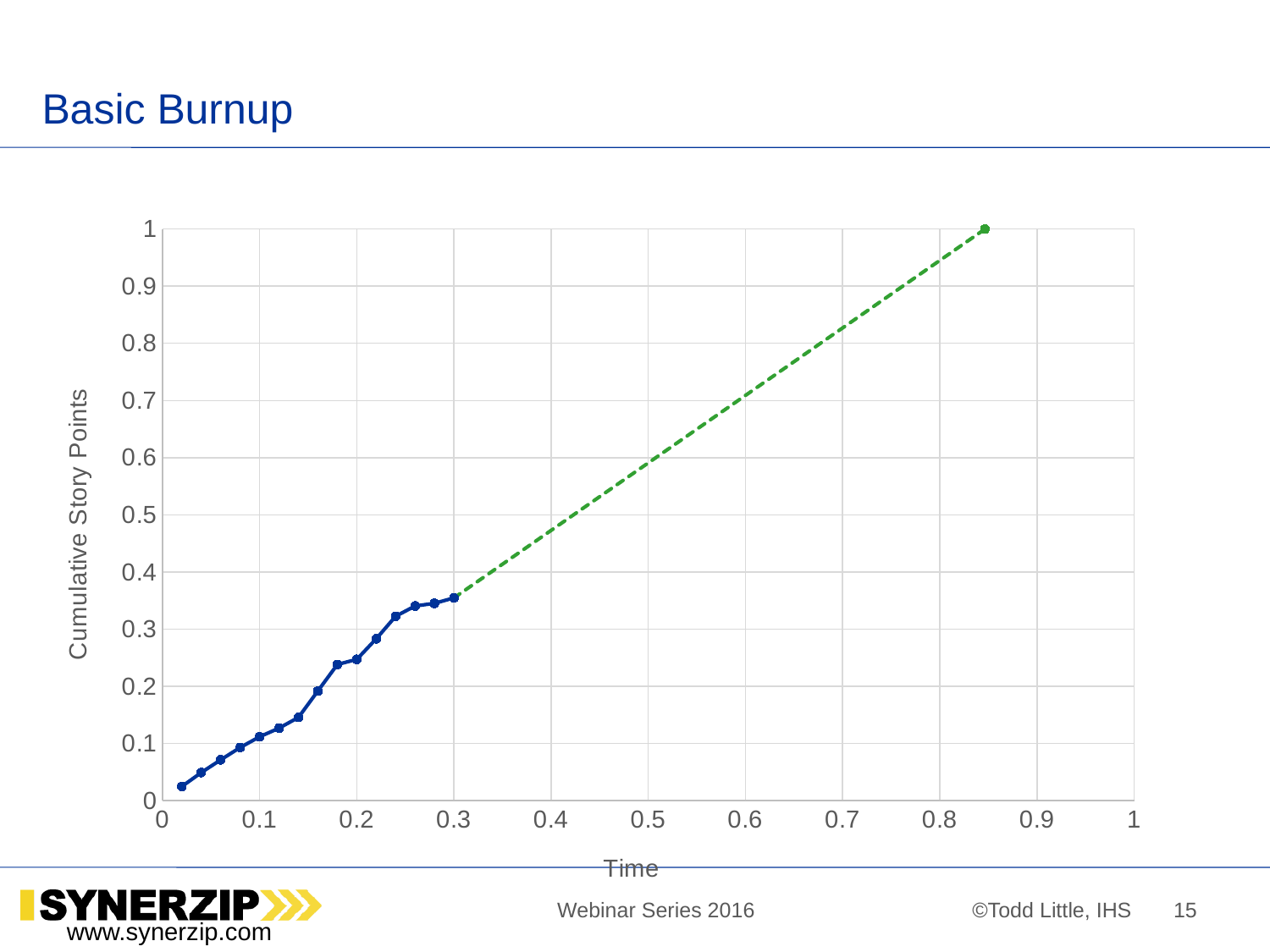
Which line is larger at Time 0.3 and beyond: the blue solid line's final value or the green dashed line's end value? the green dashed line's end value Is the Cumulative Story Points value of the blue line at Time 0.1 greater or less than 0.2? less Is the Cumulative Story Points value of the blue line at Time 0.3 greater or less than 0.4? less What kind of chart is shown on the slide? line chart Is the highest Cumulative Story Points value reached by the blue solid line greater or less than 0.5? less What Cumulative Story Points value does the green dashed line reach at its end point? 1 What is the title of the chart? Basic Burnup Do the values of the blue line rise or fall as Time increases? rise How many data points are plotted on the blue solid line? 15 What is the label of the vertical axis? Cumulative Story Points